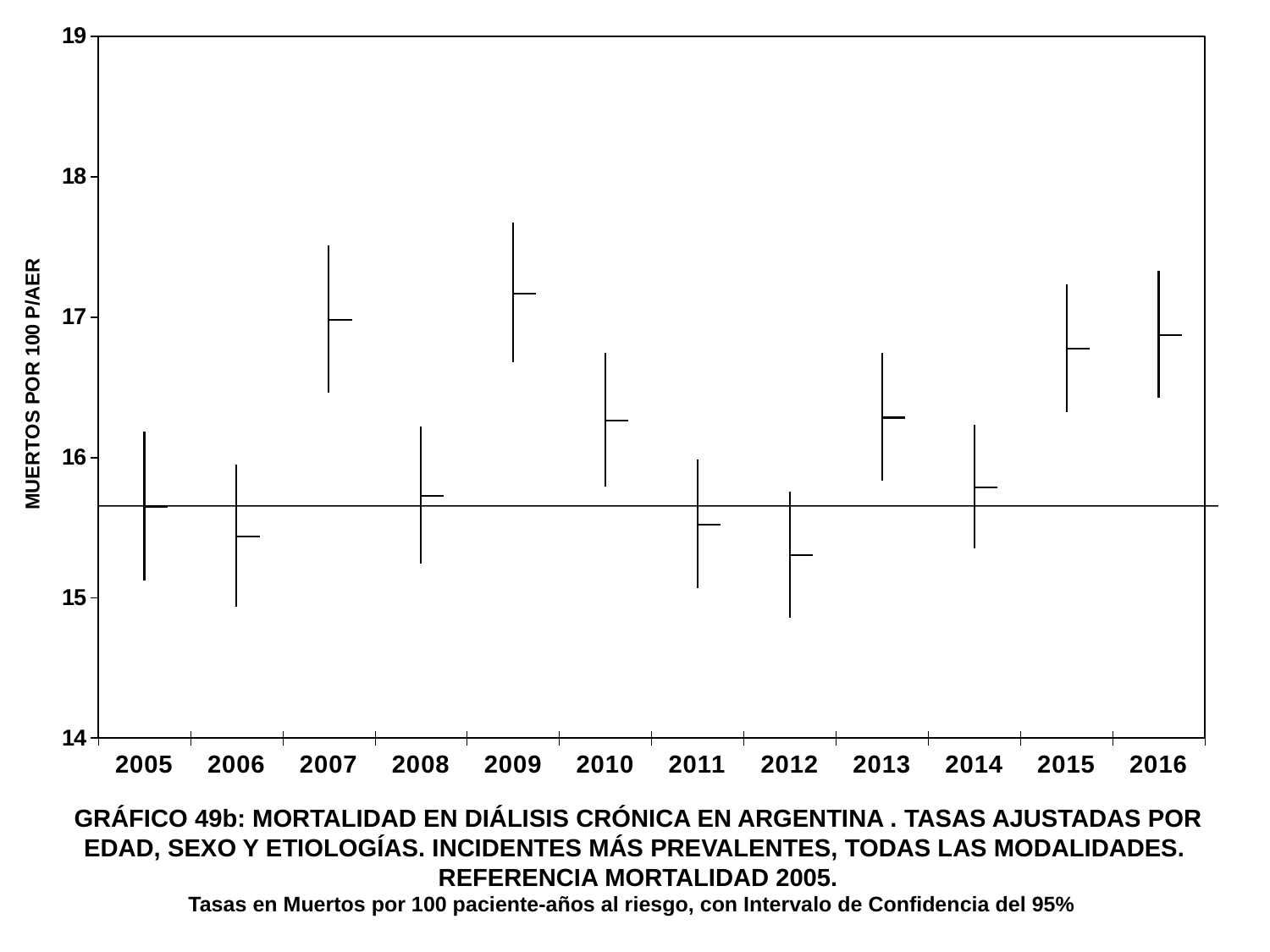
What kind of chart is shown on the slide? A point chart with error bars (confidence intervals) Is the mortality rate for 2009 greater or less than 17? greater Which year has a higher mortality rate, 2005 or 2009? 2009 Which year has the lowest adjusted mortality rate in the chart? 2012 How many years are plotted on the x axis of the chart? 12 What is the label of the y axis of the chart? MUERTOS POR 100 P/AER Is the mortality rate for 2016 greater or less than 17? less Is the mortality rate for 2006 greater or less than 16? less Which year has a higher mortality rate, 2007 or 2008? 2007 Which year has the highest adjusted mortality rate in the chart? 2009